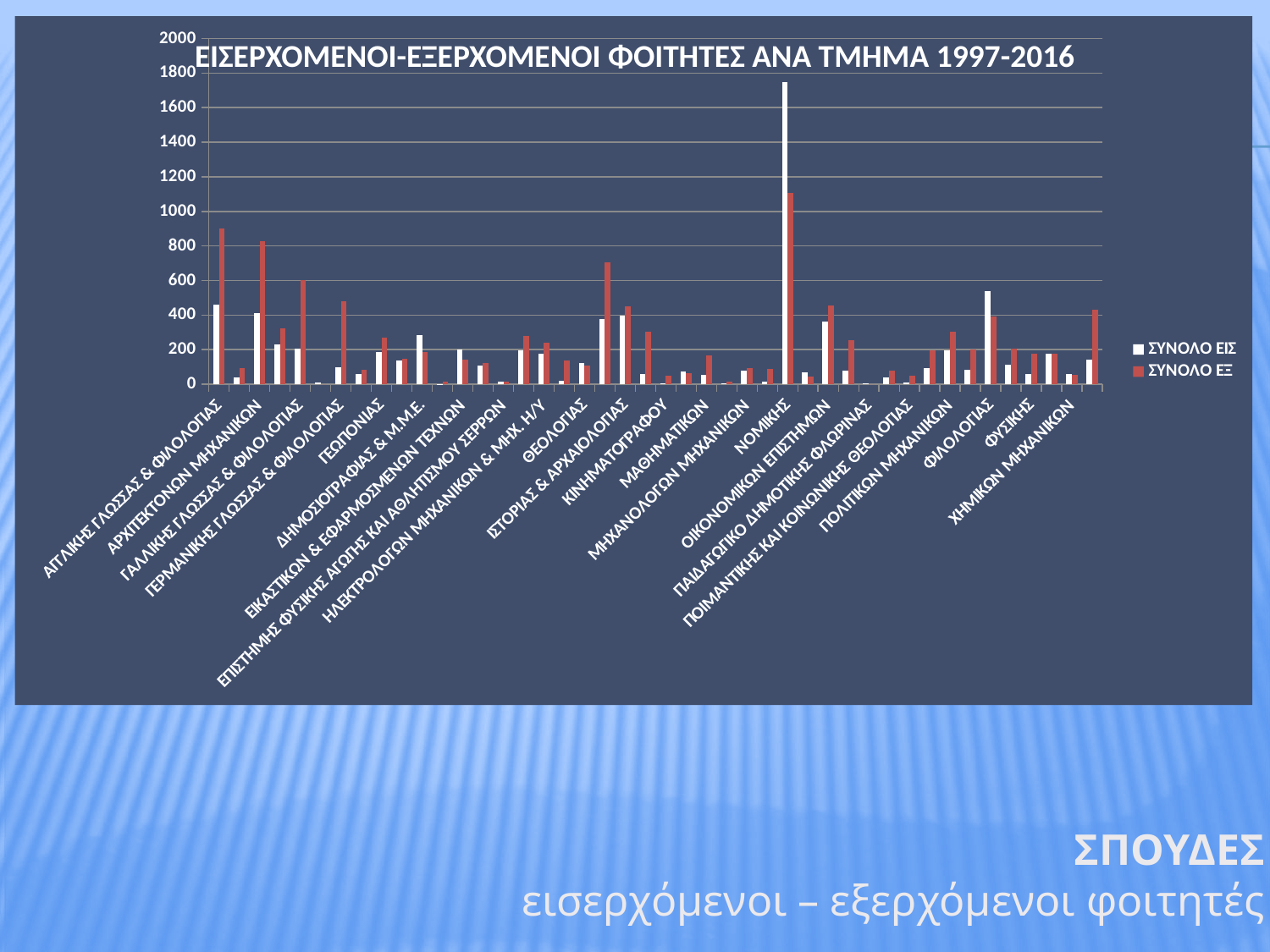
Which department has the highest ΣΥΝΟΛΟ ΕΞ value? ΝΟΜΙΚΗΣ Is the ΣΥΝΟΛΟ ΕΞ value for ΝΟΜΙΚΗΣ greater or less than 1000? greater Is the ΣΥΝΟΛΟ ΕΙΣ value for ΑΓΓΛΙΚΗΣ ΓΛΩΣΣΑΣ & ΦΙΛΟΛΟΓΙΑΣ greater or less than 600? less What is the title of the chart? ΕΙΣΕΡΧΟΜΕΝΟΙ-ΕΞΕΡΧΟΜΕΝΟΙ ΦΟΙΤΗΤΕΣ ΑΝΑ ΤΜΗΜΑ 1997-2016 Which department has the highest ΣΥΝΟΛΟ ΕΙΣ value? ΝΟΜΙΚΗΣ Is the ΣΥΝΟΛΟ ΕΞ value for ΑΓΓΛΙΚΗΣ ΓΛΩΣΣΑΣ & ΦΙΛΟΛΟΓΙΑΣ greater or less than 800? greater How many series does the legend list? 2 Which series is shown in red in the legend? ΣΥΝΟΛΟ ΕΞ What kind of chart is shown on the slide? bar chart For ΑΓΓΛΙΚΗΣ ΓΛΩΣΣΑΣ & ΦΙΛΟΛΟΓΙΑΣ, which is larger: ΣΥΝΟΛΟ ΕΙΣ or ΣΥΝΟΛΟ ΕΞ? ΣΥΝΟΛΟ ΕΞ For ΝΟΜΙΚΗΣ, which is larger: ΣΥΝΟΛΟ ΕΙΣ or ΣΥΝΟΛΟ ΕΞ? ΣΥΝΟΛΟ ΕΙΣ